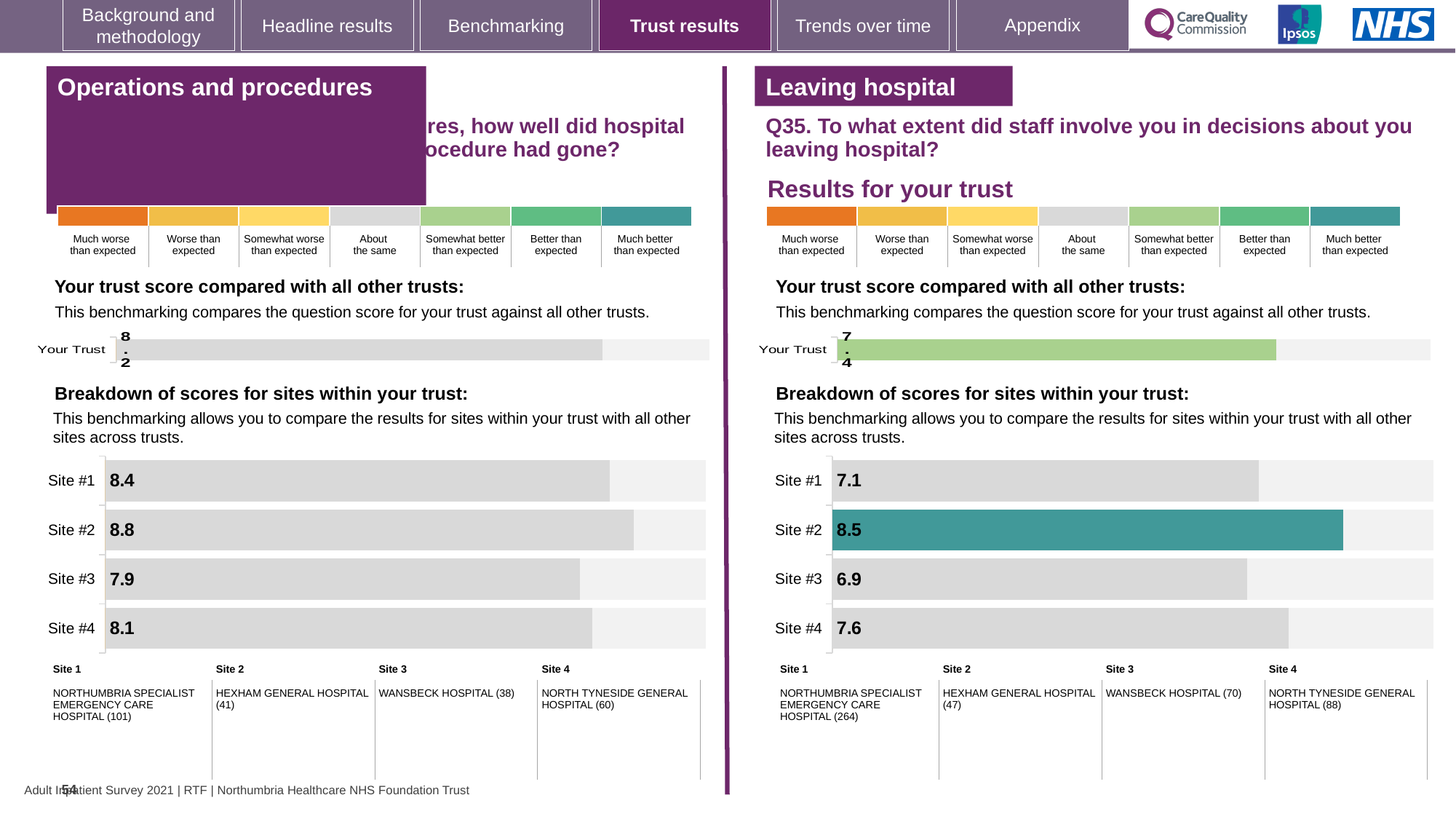
In the 'Operations and procedures' site breakdown chart, what is the score for Site #3? 7.9 In the 'Leaving hospital' section, what is the 'Your Trust' score shown in the trust comparison chart? 7.4 In the 'Operations and procedures' site breakdown chart, which has the larger score, Site #1 or Site #4? Site #1 In the 'Operations and procedures' section, what is the 'Your Trust' score shown in the trust comparison chart? 8.2 In the 'Leaving hospital' site breakdown chart, what is the difference between the scores for Site #2 and Site #3? 1.6 In the 'Operations and procedures' site breakdown chart, which site has the lowest score? Site #3 How many sites are shown in the 'Leaving hospital' site breakdown chart? 4 In the 'Leaving hospital' site breakdown chart, which site has the lowest score? Site #3 What type of chart is used for the site breakdown in the 'Leaving hospital' section? Bar chart In the 'Operations and procedures' site breakdown chart, which site has the highest score? Site #2 In the 'Leaving hospital' site breakdown chart, what is the score for Site #2? 8.5 In the 'Leaving hospital' site breakdown chart, which site has the highest score? Site #2